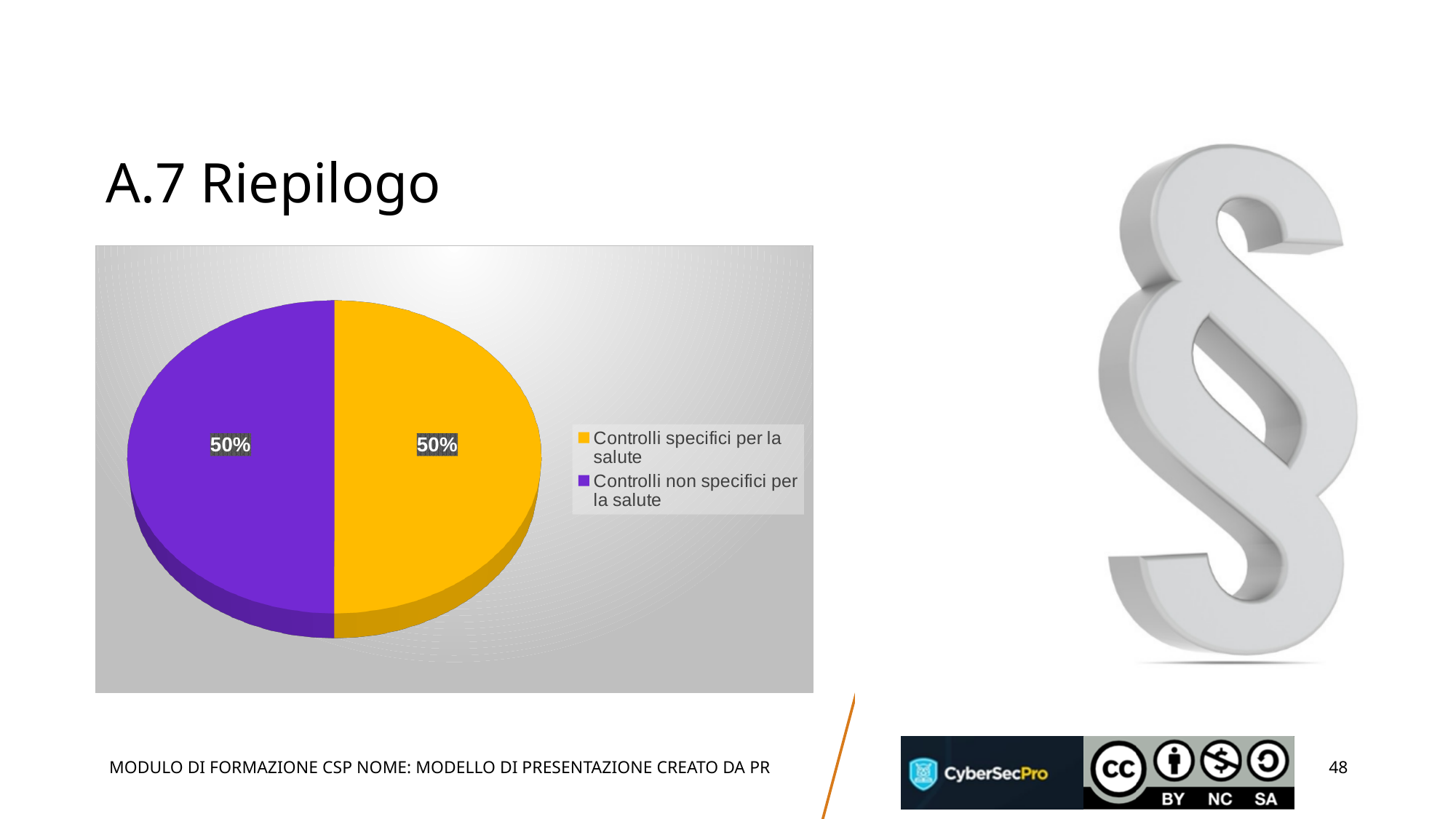
Which legend entry is shown in yellow in the pie chart? Controlli specifici per la salute What share of the pie does "Controlli specifici per la salute" represent? 50% What is the value shown on the yellow slice of the pie chart? 50% What share of the pie does "Controlli non specifici per la salute" represent? 50% How many slices does the pie chart have? 2 How many entries does the legend of the pie chart list? 2 What is the difference between the shares of "Controlli specifici per la salute" and "Controlli non specifici per la salute"? 0% Which colour represents "Controlli non specifici per la salute" in the pie chart? purple What kind of chart is shown on the slide? pie chart